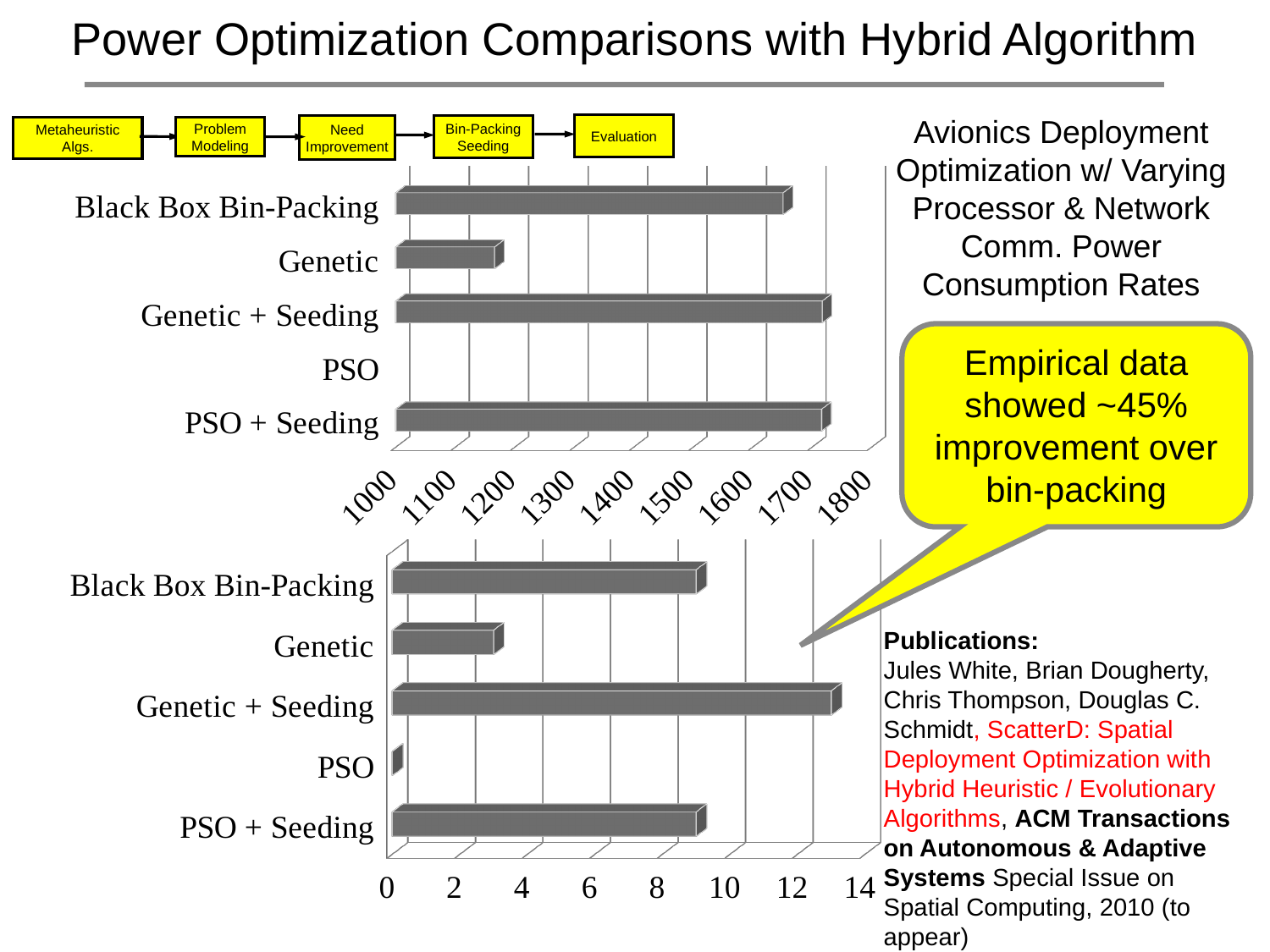
In the bottom chart (x axis 0 to 14), is the value for Black Box Bin-Packing greater or less than 8? greater What kind of chart is the top chart on the slide? bar chart In the bottom chart (x axis 0 to 14), is the value for Genetic greater or less than 4? less In the top chart (x axis 1000 to 1800), is the value for Genetic greater or less than 1200? less In the bottom chart (x axis 0 to 14), which category has the highest value? Genetic + Seeding In the top chart (x axis 1000 to 1800), which is larger, the value for Black Box Bin-Packing or the value for Genetic? Black Box Bin-Packing In the bottom chart (x axis 0 to 14), which is larger, the value for Genetic + Seeding or the value for Genetic? Genetic + Seeding In the bottom chart (x axis 0 to 14), which category has the lowest value? PSO How many categories are listed on the y axis of the top chart (x axis 1000 to 1800)? 5 How many categories are shown in the bottom chart (x axis 0 to 14)? 5